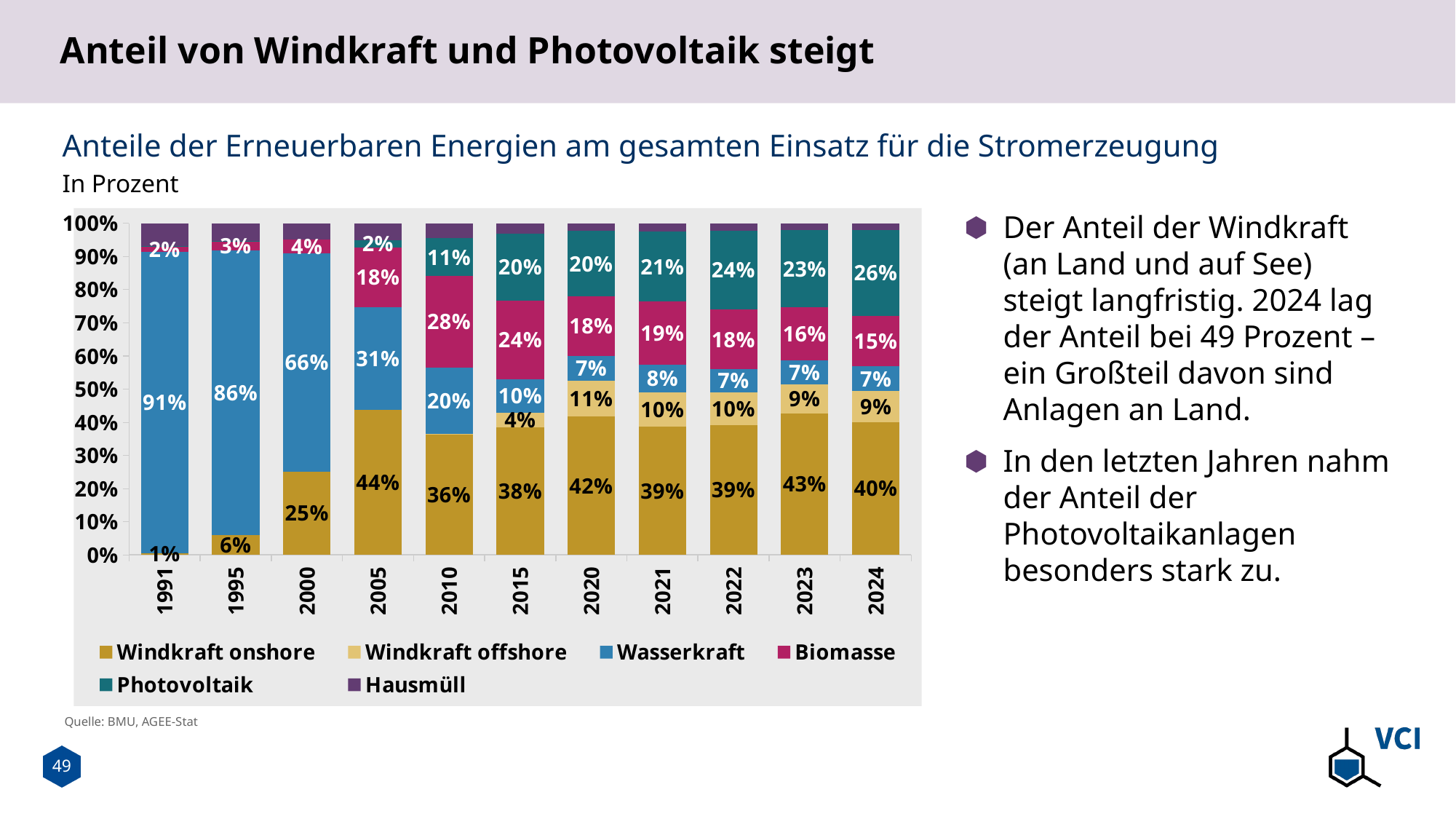
Does the share of Wasserkraft rise or fall from 1991 to 2024? Fall By how many percentage points did the Photovoltaik share in 2024 exceed its share in 2015? 6 Which was larger in 2005: the share of Wasserkraft or the share of Biomasse? Wasserkraft How many series does the legend list? 6 What share did Wasserkraft have in 1991? 91% What share did Biomasse have in 2010? 28% What kind of chart is shown on the slide? Stacked bar chart What share did Windkraft offshore have in 2020? 11% In which year was the share of Windkraft onshore highest? 2005 How many years are shown on the x axis? 11 What share did Photovoltaik have in 2024? 26%